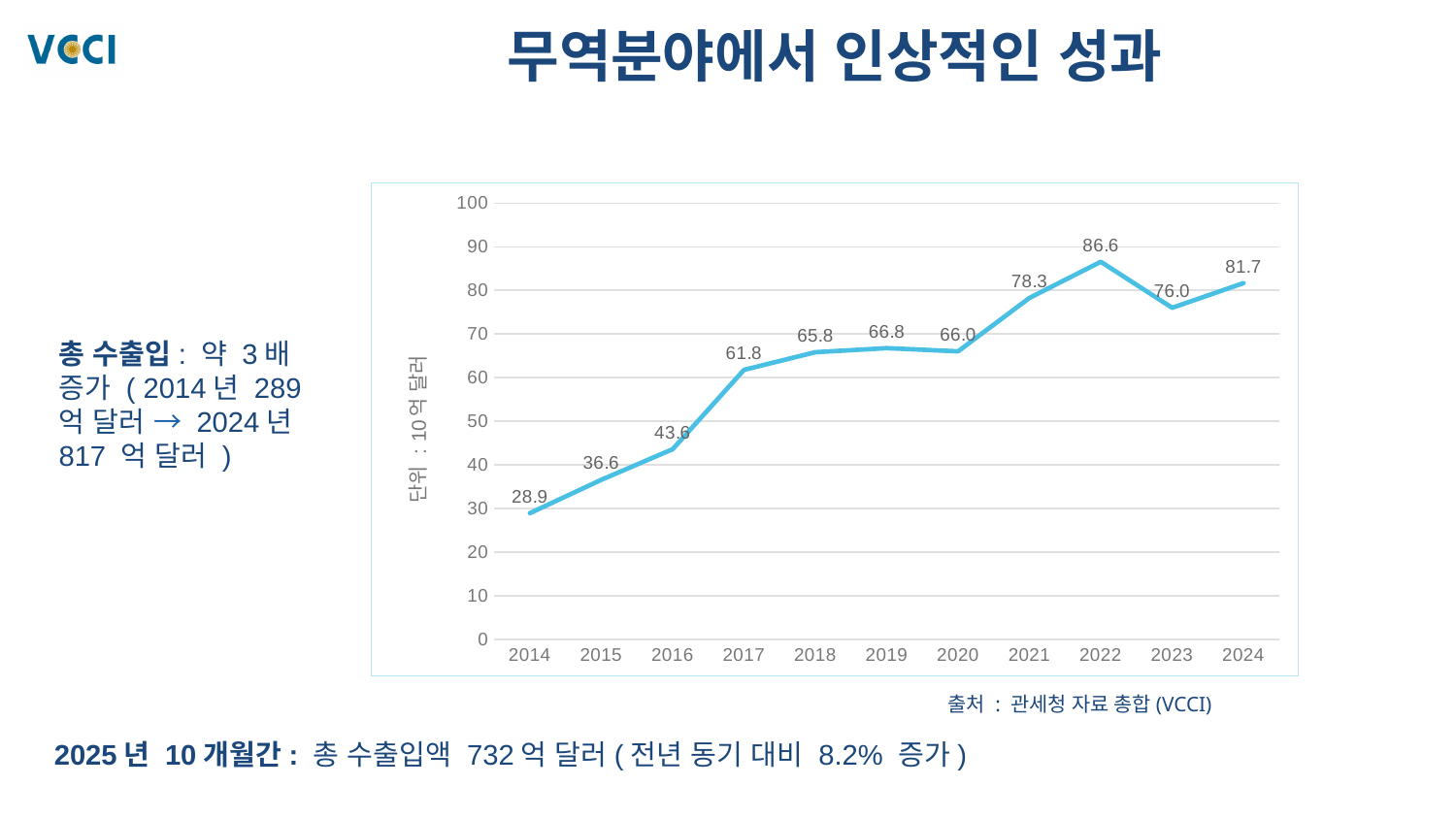
What type of chart is shown on the slide? line chart What unit is given on the y axis label? 10억 달러 What is the value for 2024? 81.7 What is the value for 2022? 86.6 What is the value for 2014? 28.9 What is the difference between the values for 2022 and 2023? 10.6 How many years are plotted on the x axis? 11 Which year has the highest value? 2022 Which is larger, the value for 2019 or the value for 2020? 2019 Which year has the lowest value? 2014 What is the value for 2017? 61.8 What is the difference between the values for 2024 and 2014? 52.8